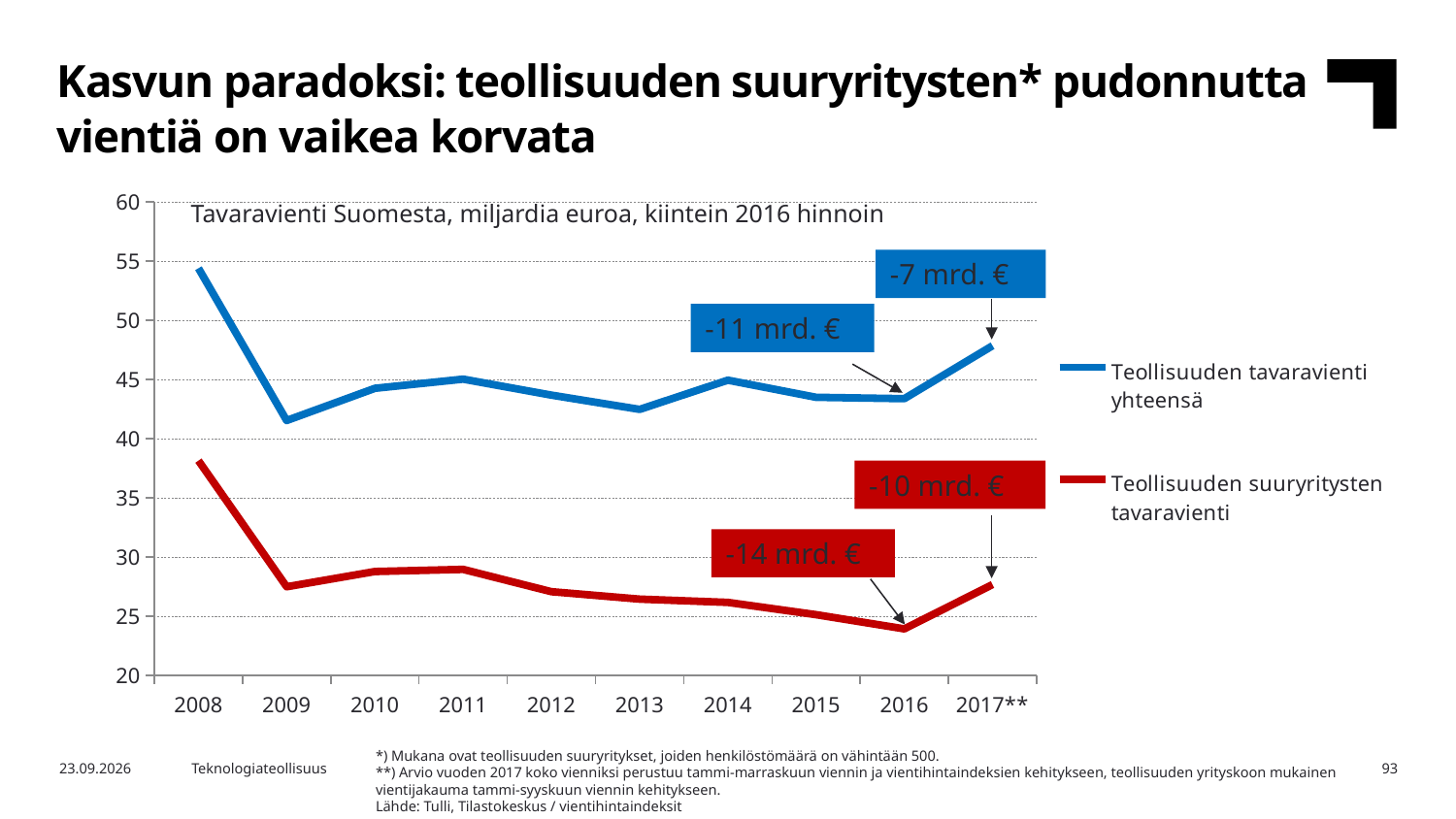
In which year is Teollisuuden suuryritysten tavaravienti lowest? 2016 Is the value for Teollisuuden tavaravienti yhteensä in 2008 greater or less than 50? greater How many years are shown on the x axis? 10 What kind of chart is shown on the slide? line chart Do the values of Teollisuuden tavaravienti yhteensä rise or fall from 2008 to 2009? fall How many series does the legend list? 2 In which year is Teollisuuden tavaravienti yhteensä highest? 2008 Is the value for Teollisuuden suuryritysten tavaravienti in 2016 greater or less than 25? less Is the value for Teollisuuden suuryritysten tavaravienti in 2008 greater or less than 35? greater Which series has the larger value in 2014, Teollisuuden tavaravienti yhteensä or Teollisuuden suuryritysten tavaravienti? Teollisuuden tavaravienti yhteensä Which colour represents Teollisuuden suuryritysten tavaravienti? red What is the title of the chart? Tavaravienti Suomesta, miljardia euroa, kiintein 2016 hinnoin